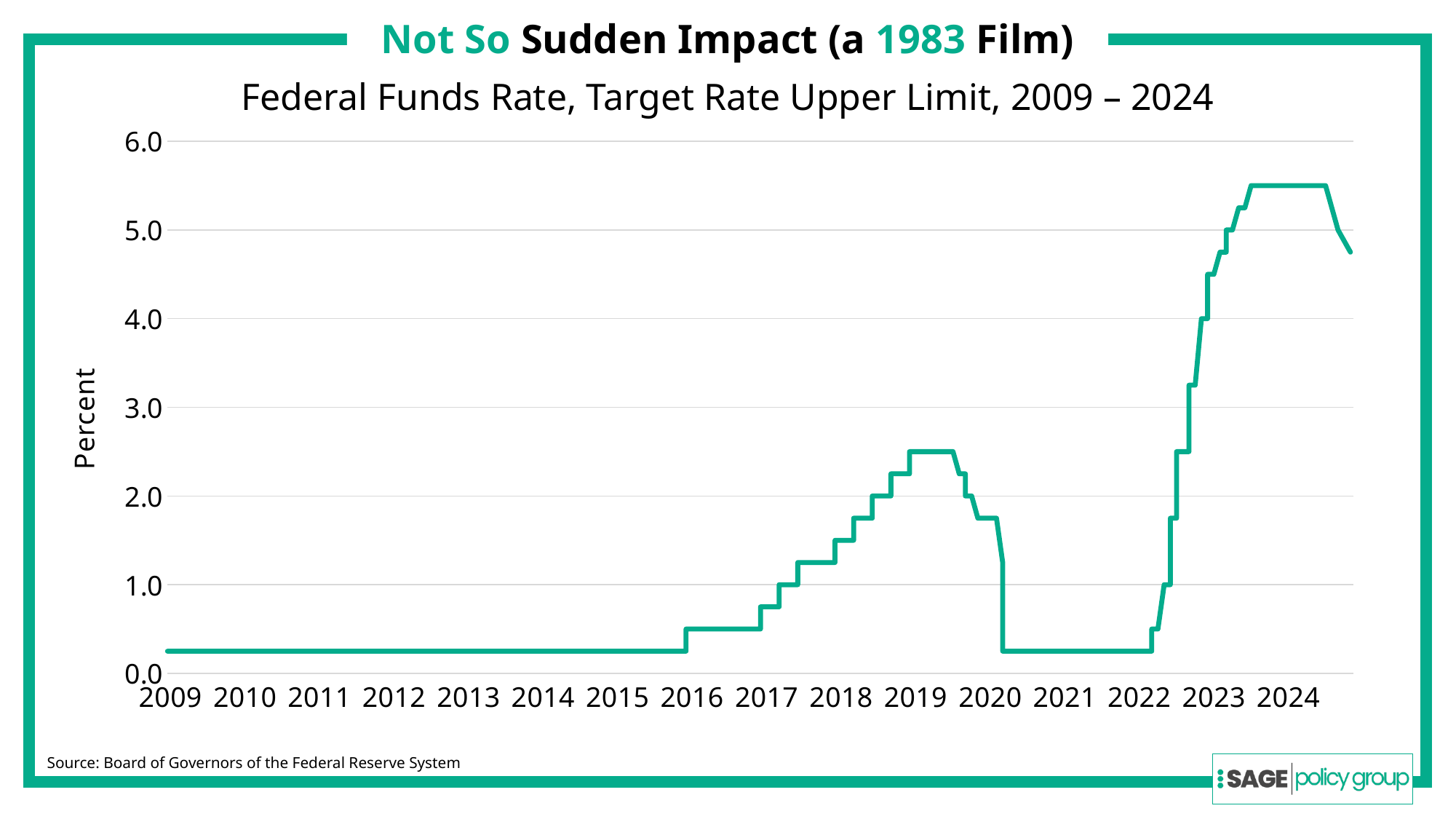
Is the value at the start of 2019 greater or less than 2.0? greater What is the title of the chart? Federal Funds Rate, Target Rate Upper Limit, 2009 – 2024 Is the value for 2017 greater or less than 2.0? less Is the value for 2021 greater or less than 1.0? less Does the line rise or fall between 2019 and 2020? fall What is the label on the vertical axis of the chart? Percent How many year labels are shown on the x axis? 16 Does the line rise or fall between 2022 and 2023? rise Is the value in 2024 higher or lower than the value in 2019? higher What kind of chart is shown on the slide? line chart